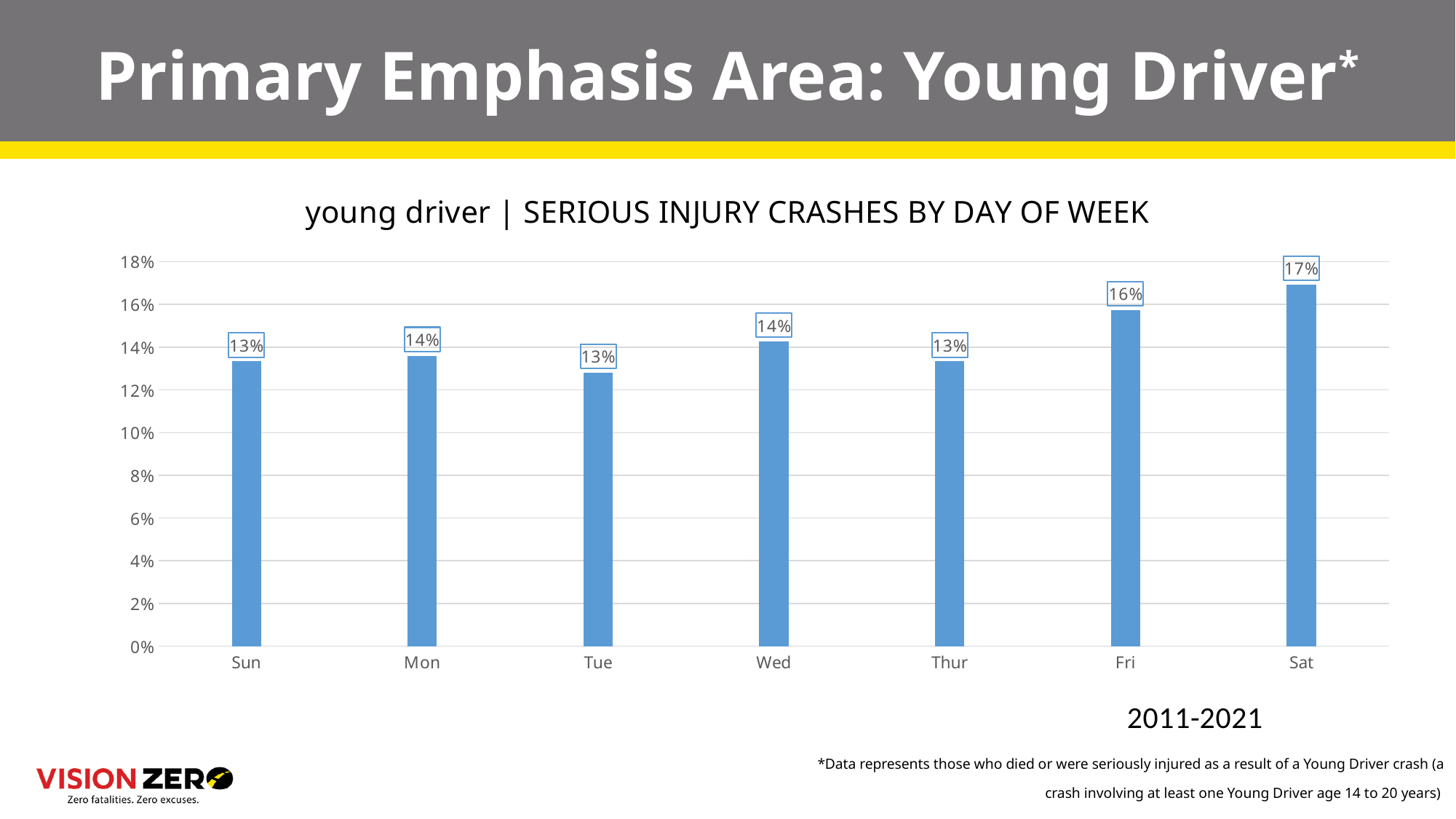
Is the value for Sat greater or less than 16%? greater What is the value for Sat? 17% How many days of the week are shown on the x axis? 7 What is the title of the chart? young driver | SERIOUS INJURY CRASHES BY DAY OF WEEK What is the difference between the values for Fri and Wed? 2% What is the value for Wed? 14% What is the value for Fri? 16% What kind of chart is shown on the slide? Bar chart What is the value for Tue? 13% What is the difference between the values for Sat and Tue? 4% Which day of the week has the highest share of serious injury crashes? Sat Which is larger, the value for Fri or the value for Mon? Fri